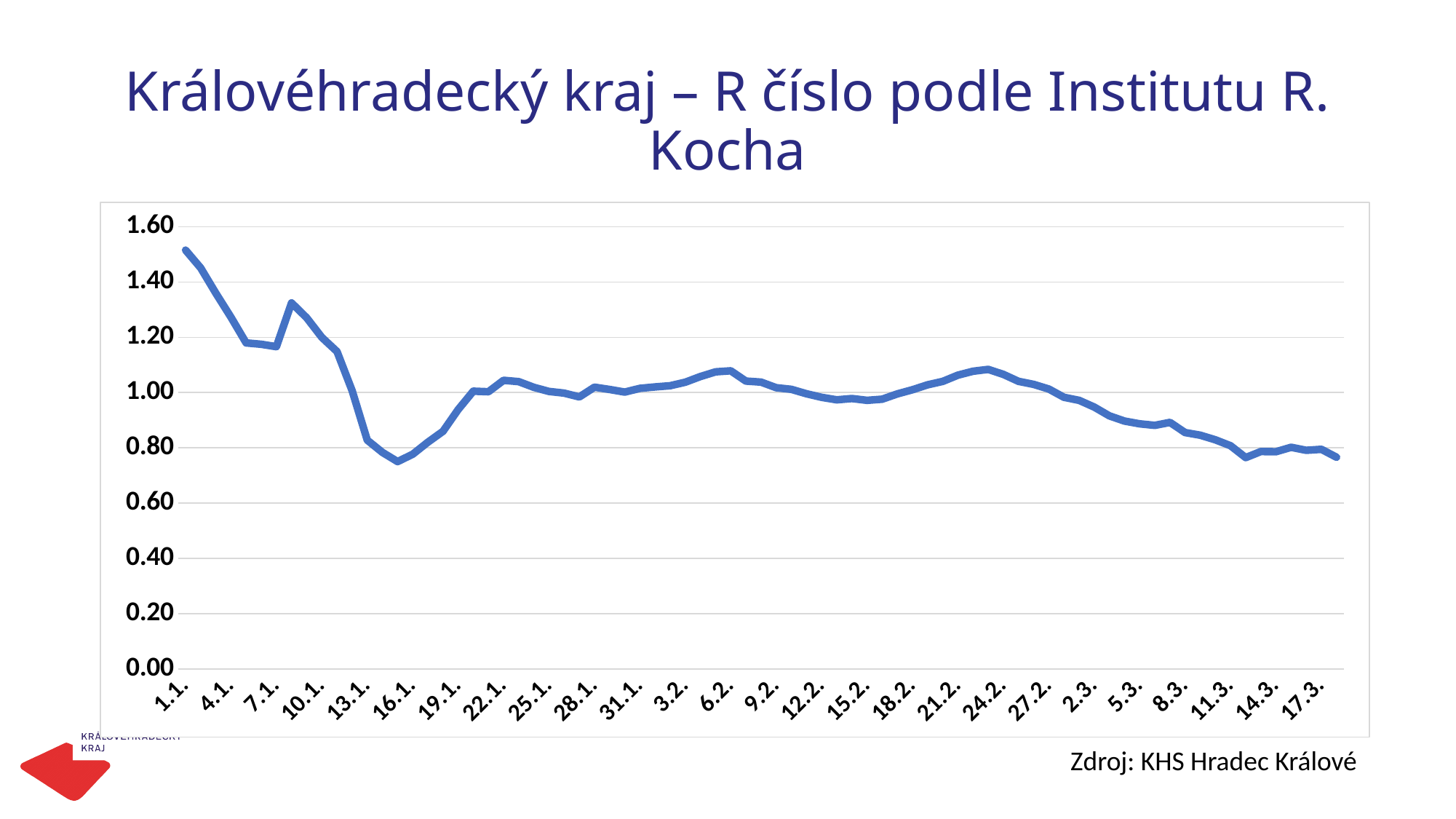
Is the value for 1.1. greater or less than 1.40? greater Is the value for 16.1. greater or less than 0.80? less Is the value for 8.3. greater or less than 1.00? less What kind of chart is shown on the slide? line chart What is the title of the chart on the slide? Královéhradecký kraj – R číslo podle Institutu R. Kocha What source is cited below the chart? KHS Hradec Králové Which date on the x axis has the highest R value? 1.1. Which has the larger value, 1.1. or 17.3.? 1.1. Overall, does the R value rise or fall from 1.1. to 17.3.? fall Which has the larger value, 10.1. or 16.1.? 10.1.